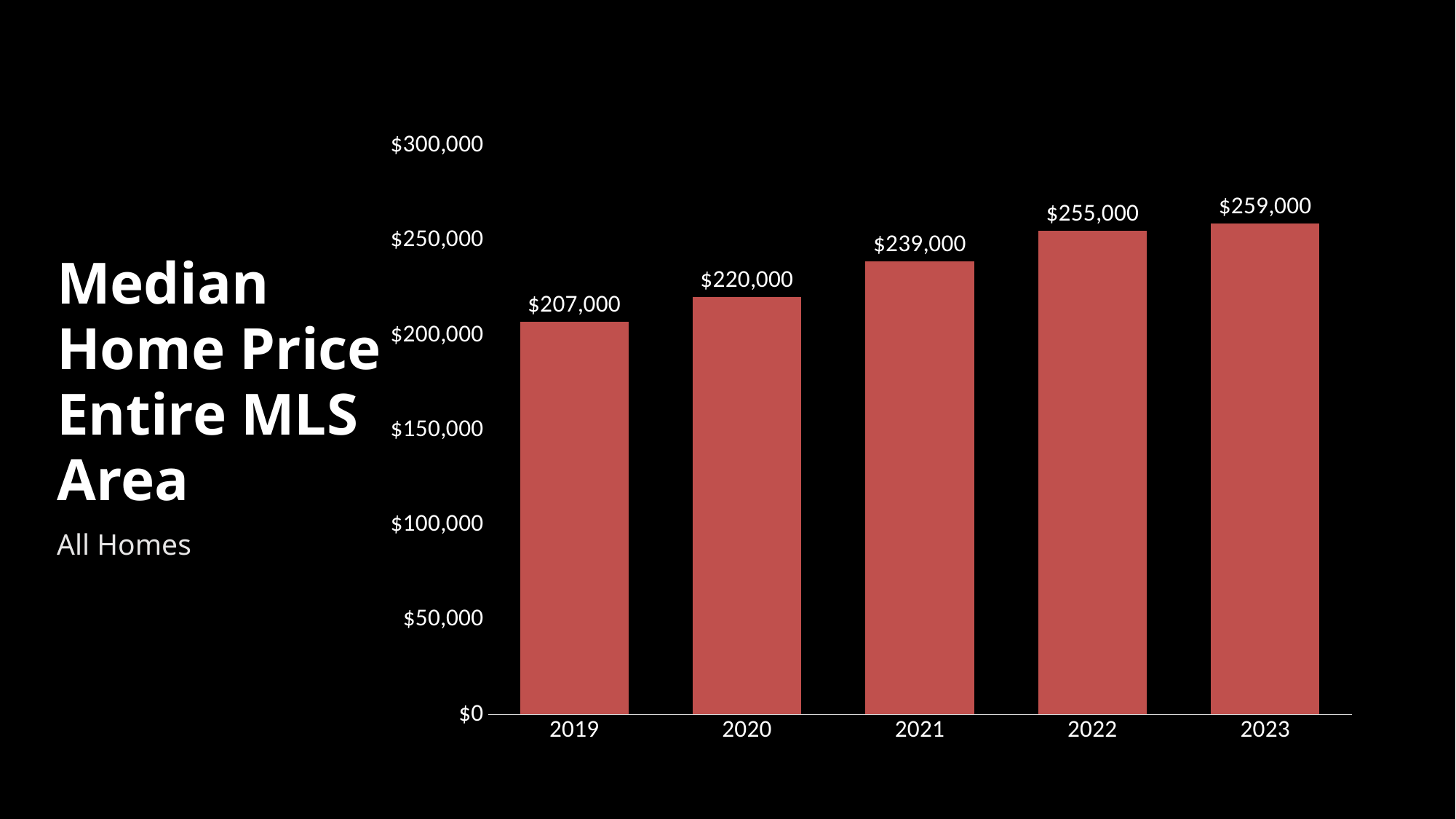
What is the difference between the median home price in 2022 and in 2021? $16,000 What kind of chart is shown on the slide? bar chart Do the median home prices rise or fall from 2019 to 2023? rise What is the median home price for 2021? $239,000 What is the median home price for 2023? $259,000 What is the median home price for 2019? $207,000 How many years are shown on the chart? 5 Is the median home price for 2020 greater or less than $250,000? less Which year has the highest median home price? 2023 Which year has the lowest median home price? 2019 What is the difference between the median home price in 2023 and in 2019? $52,000 Which year has a higher median home price, 2020 or 2022? 2022